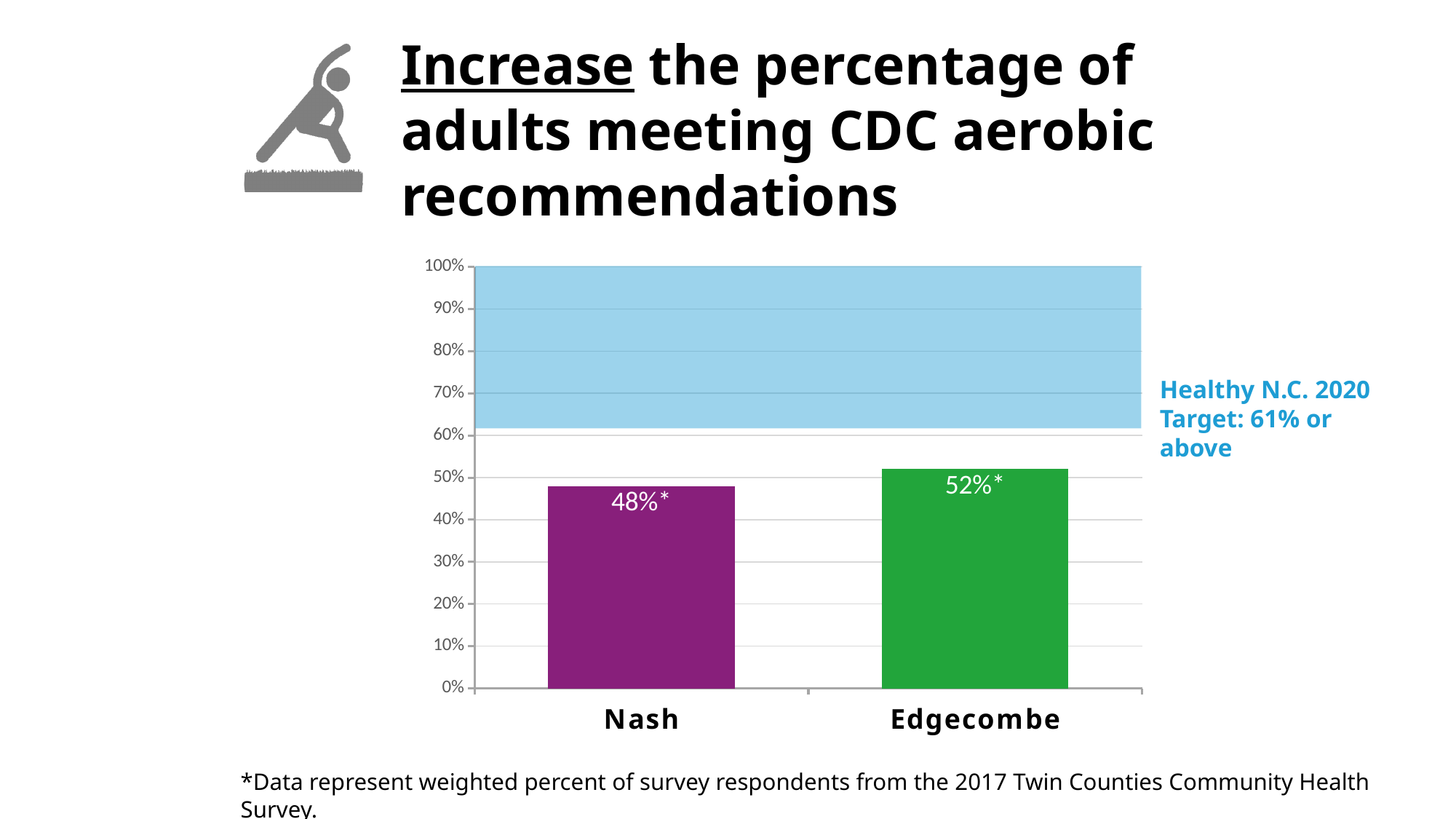
What colour is the bar for Nash? purple What kind of chart is shown on the slide? bar chart How many counties are shown on the chart? 2 What is the value for Nash? 48% Which county has the higher percentage of adults meeting CDC aerobic recommendations? Edgecombe Is the value for Edgecombe greater or less than 60%? less What is the value for Edgecombe? 52% Is the value for Nash greater or less than 50%? less Which county has the lower percentage of adults meeting CDC aerobic recommendations? Nash What is the difference between the values for Edgecombe and Nash? 4% What is the Healthy N.C. 2020 target shown on the chart? 61% or above Does either county meet the Healthy N.C. 2020 target of 61%? No